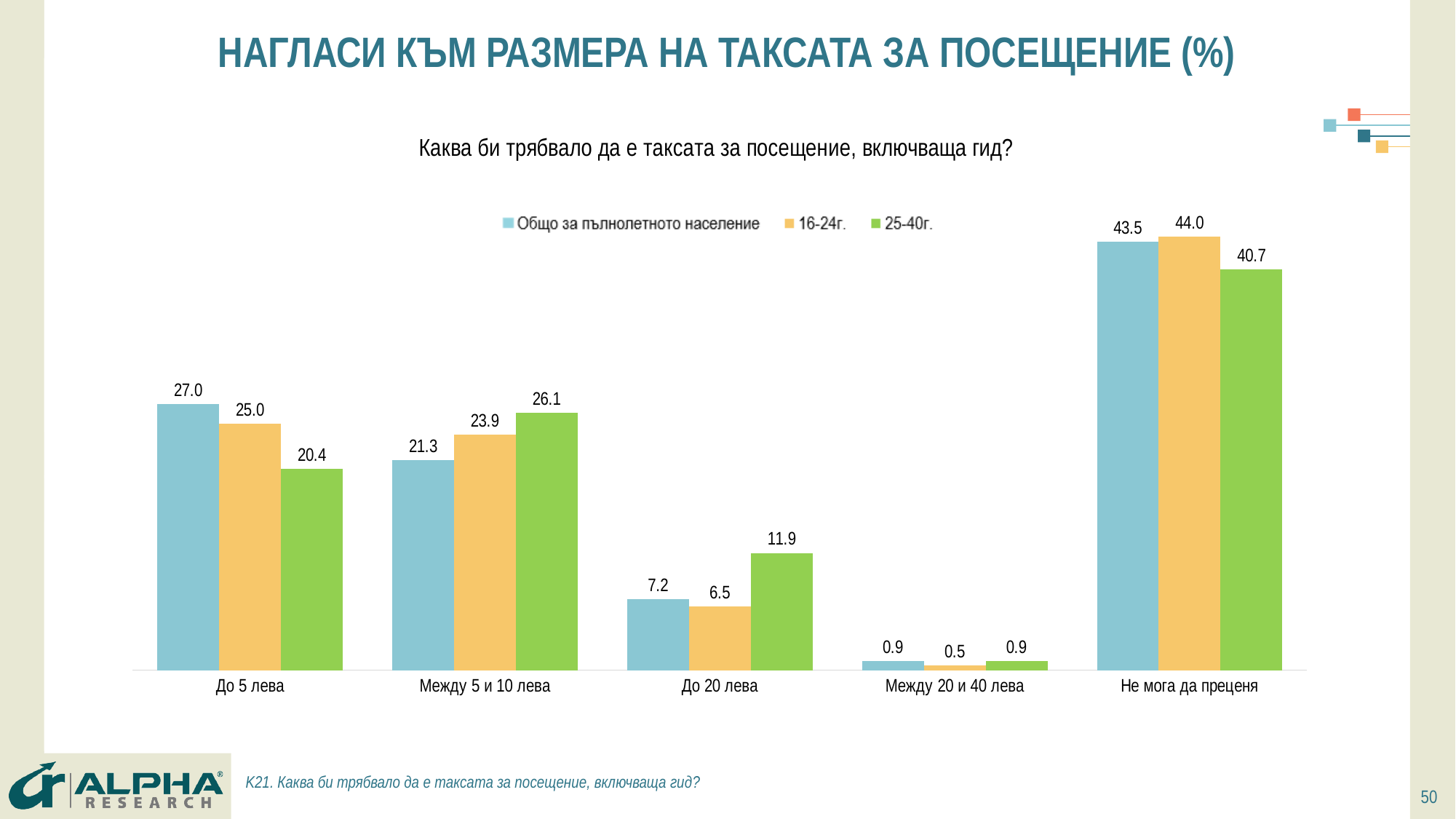
What is the value for "До 5 лева" in the "Общо за пълнолетното население" series? 27.0 Which colour represents the "25-40г." series? Green How many series does the legend list? 3 For "До 20 лева", which series has the larger value: "Общо за пълнолетното население" or "25-40г."? 25-40г. What is the value for "До 20 лева" in the "16-24г." series? 6.5 How many categories are shown on the x axis? 5 What kind of chart is shown on the slide? Bar chart What is the difference between the "16-24г." and "25-40г." values for "Не мога да преценя"? 3.3 Which category has the highest value in the "16-24г." series? Не мога да преценя What is the value for "Между 5 и 10 лева" in the "25-40г." series? 26.1 What is the difference between the "Общо за пълнолетното население" and "25-40г." values for "До 5 лева"? 6.6 Which category has the lowest value in the "25-40г." series? Между 20 и 40 лева